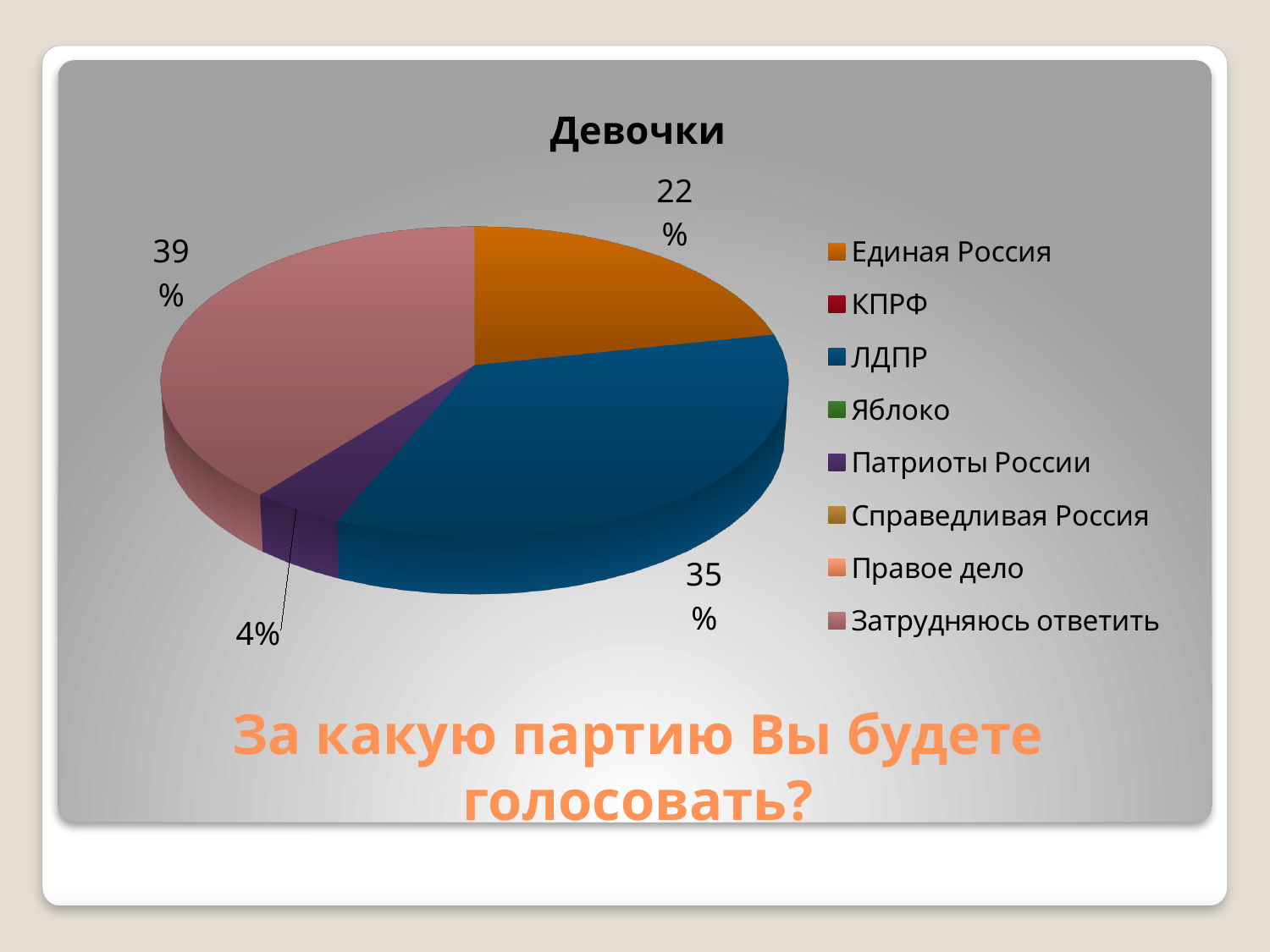
What share of the pie does Единая Россия have? 22% What share of the pie does Затрудняюсь ответить have? 39% How many entries does the legend list? 8 What is the difference between the shares of Затрудняюсь ответить and Единая Россия? 17% Which is larger, the share for ЛДПР or the share for Единая Россия? ЛДПР What type of chart is shown on the slide? pie chart What share of the pie does ЛДПР have? 35% Which of the labelled slices is the smallest? Патриоты России What share of the pie does Патриоты России have? 4% What is the title of the chart? Девочки What is the difference between the shares of ЛДПР and Патриоты России? 31% Which category has the largest slice of the pie? Затрудняюсь ответить